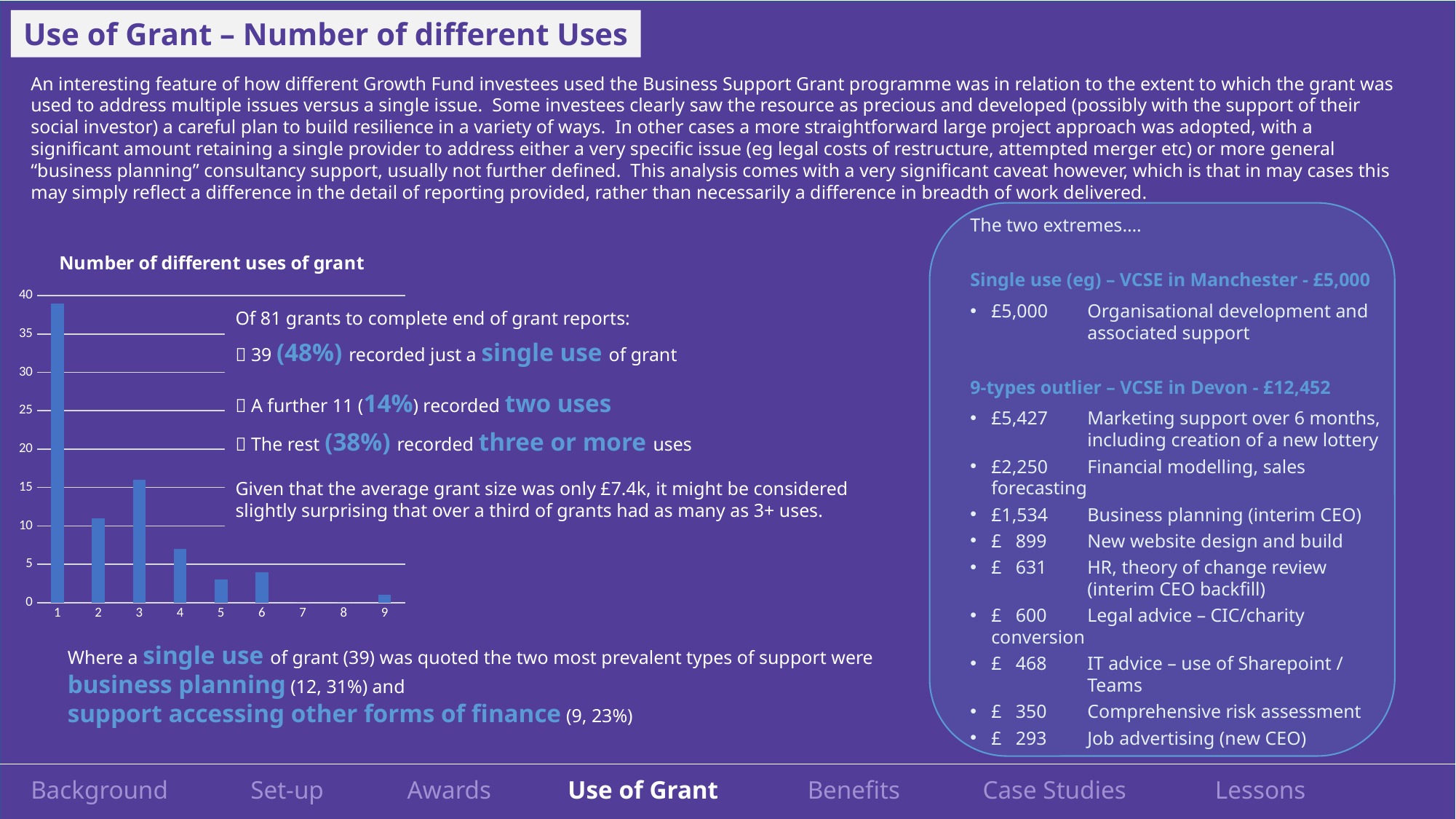
Is the value for category 3 greater or less than 10? greater What kind of chart is 'Number of different uses of grant'? bar chart Which is larger, the value for category 4 or category 6? 4 How many categories are shown on the x axis of the 'Number of different uses of grant' chart? 9 Is the value for category 1 greater or less than 35? greater What is the title of the chart on the slide? Number of different uses of grant Do the values generally rise or fall as the number of uses increases along the x axis? fall Is the value for category 2 greater or less than 15? less Which is larger, the value for category 2 or category 3? 3 Which category has the highest bar in the 'Number of different uses of grant' chart? 1